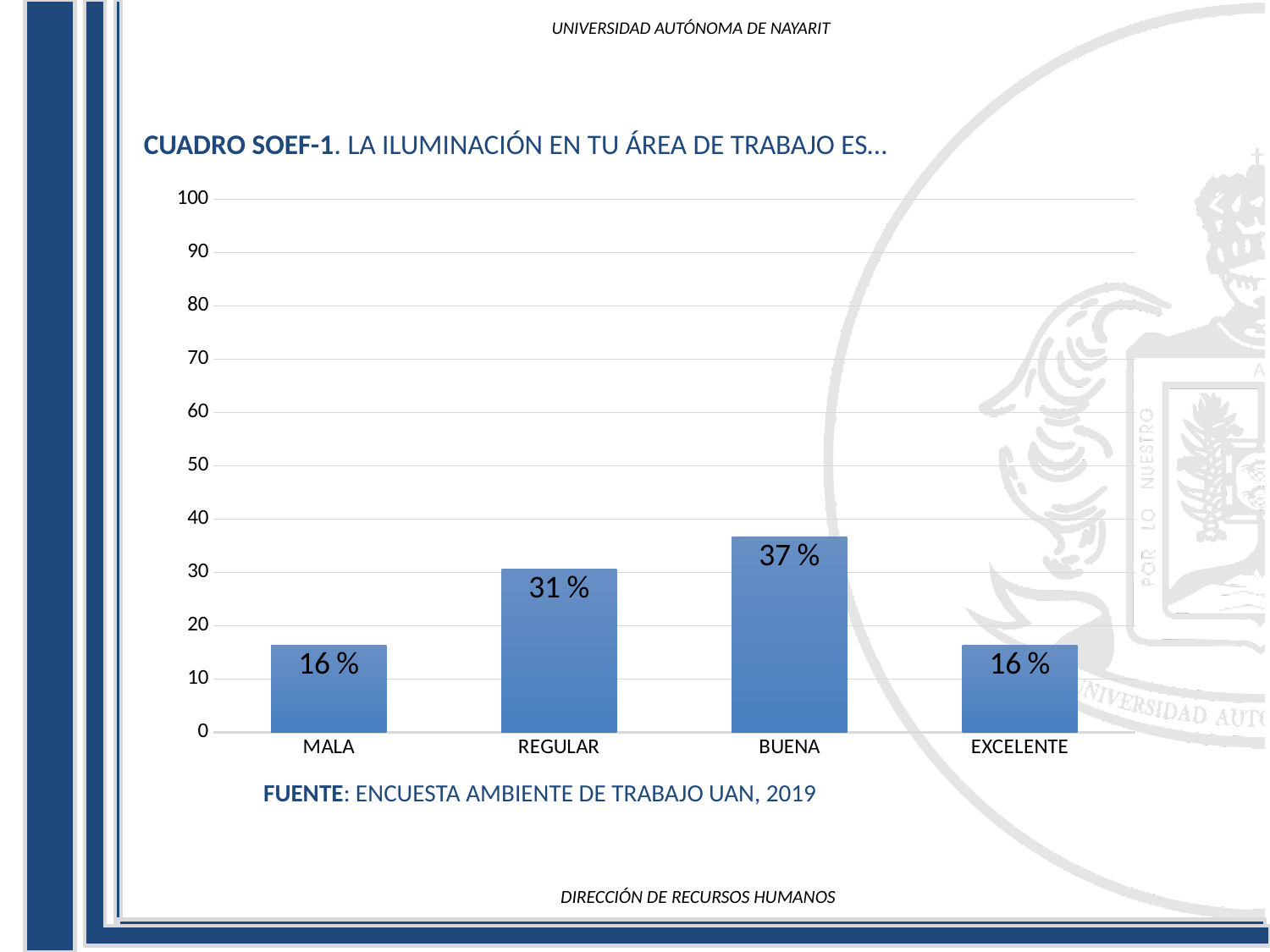
Which category has the highest value? BUENA What is the value for EXCELENTE? 16 % What source is cited below the chart? ENCUESTA AMBIENTE DE TRABAJO UAN, 2019 What is the value for BUENA? 37 % Which is larger, the value for REGULAR or the value for EXCELENTE? REGULAR How many categories are shown on the x axis? 4 What is the value for REGULAR? 31 % What kind of chart is shown on the slide? bar chart What is the difference between the values for REGULAR and MALA? 15 % Is the value for BUENA greater or less than 40? less What is the value for MALA? 16 % What is the difference between the values for BUENA and REGULAR? 6 %